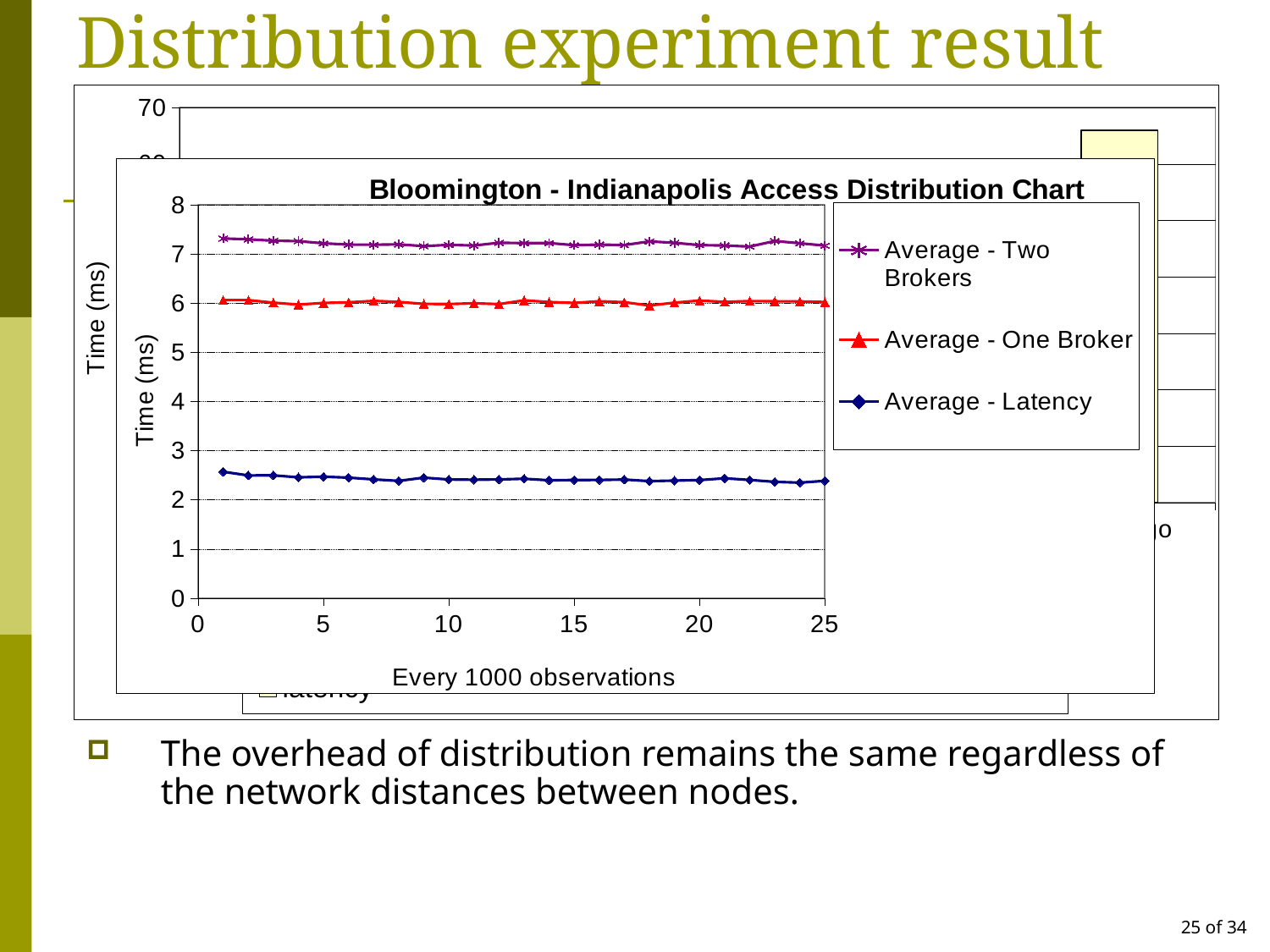
In the Bloomington - Indianapolis Access Distribution Chart, are the values for Average - One Broker greater or less than 5? greater In the Bloomington - Indianapolis Access Distribution Chart, which series has the lowest values? Average - Latency In the Bloomington - Indianapolis Access Distribution Chart, which series has the highest values? Average - Two Brokers In the Bloomington - Indianapolis Access Distribution Chart, are the values for Average - Latency greater or less than 3? less What kind of chart is the Bloomington - Indianapolis Access Distribution Chart? line chart How many series does the legend of the Bloomington - Indianapolis Access Distribution Chart list? 3 In the Bloomington - Indianapolis Access Distribution Chart, do the Average - Latency values rise, fall, or stay roughly flat along the x axis? stay roughly flat In the Bloomington - Indianapolis Access Distribution Chart, are the values for Average - Two Brokers greater or less than 7? greater In the Bloomington - Indianapolis Access Distribution Chart, which series is larger: Average - One Broker or Average - Latency? Average - One Broker What is the title of the front chart on the slide? Bloomington - Indianapolis Access Distribution Chart What is the x-axis label of the Bloomington - Indianapolis Access Distribution Chart? Every 1000 observations